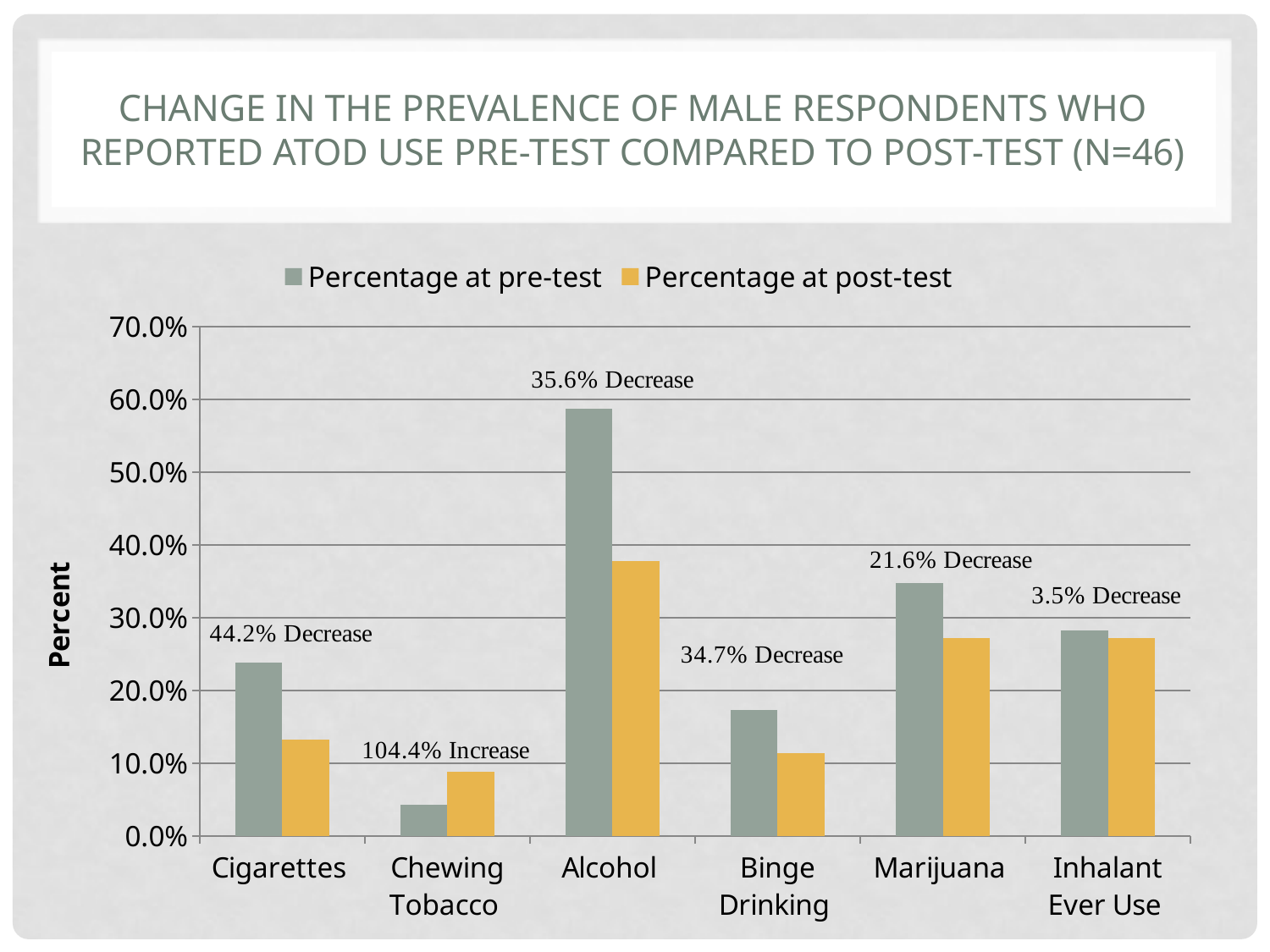
Which category is the only one annotated with an increase from pre-test to post-test? Chewing Tobacco For Cigarettes, which is larger: the percentage at pre-test or the percentage at post-test? Percentage at pre-test Which category has the highest percentage at pre-test? Alcohol How many series does the legend list? 2 Which category has the lowest percentage at pre-test? Chewing Tobacco What change is annotated above the Alcohol bars? 35.6% Decrease What change is annotated above the Chewing Tobacco bars? 104.4% Increase How many categories are shown on the x axis? 6 Is the percentage at pre-test for Alcohol greater or less than 50.0%? greater Is the percentage at post-test for Binge Drinking greater or less than 20.0%? less What kind of chart is shown on the slide? Bar chart What is the title of the y axis? Percent